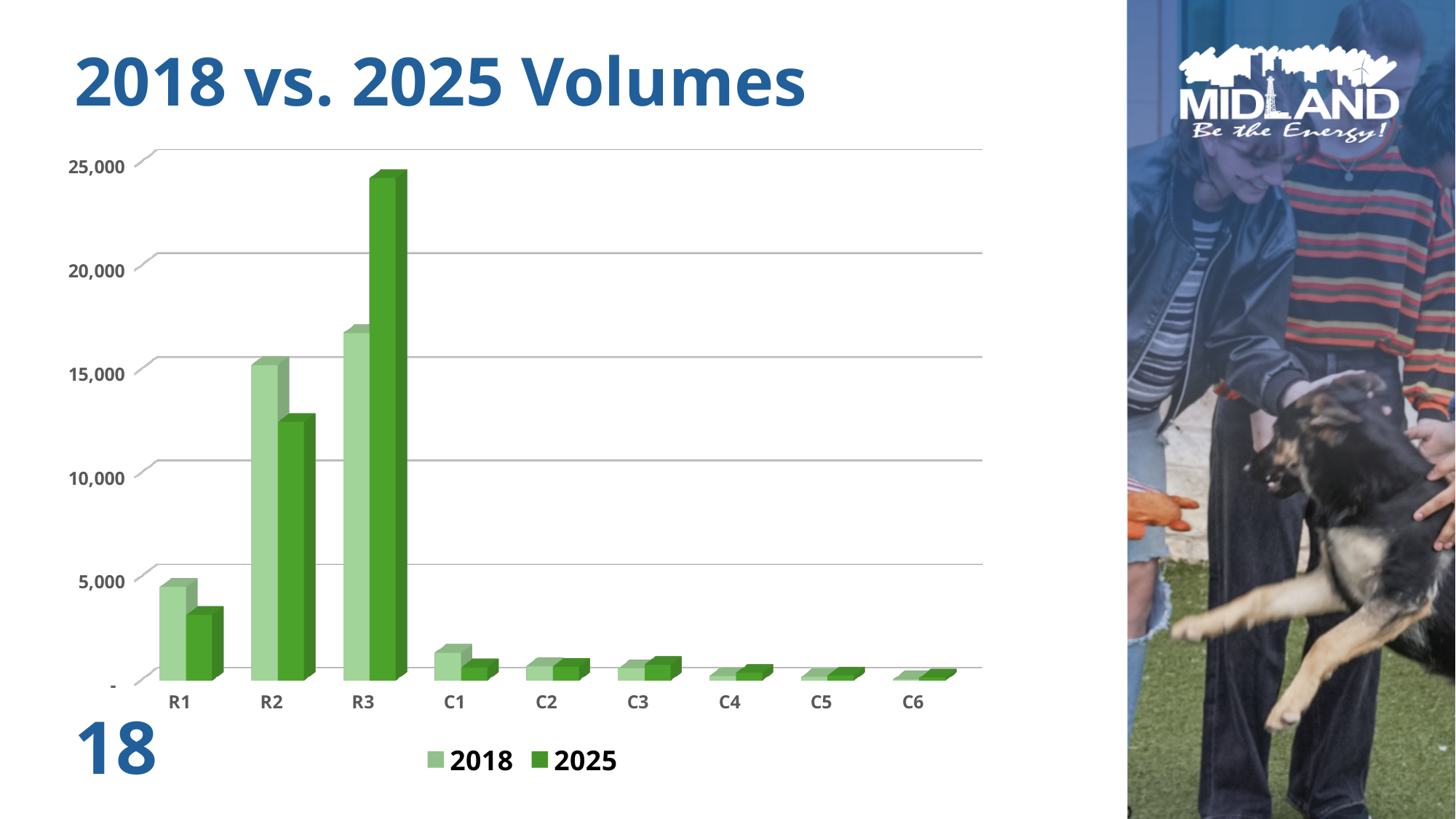
How many categories are shown on the x axis of the chart? 9 Which category has the highest 2025 value? R3 Is the 2025 value for R2 greater or less than 10,000? greater What kind of chart is shown on the slide? Bar chart For R2, which is larger: the 2018 value or the 2025 value? 2018 How many series does the chart's legend list? 2 For R1, which is larger: the 2018 value or the 2025 value? 2018 Which category has the highest 2018 value? R3 Is the 2018 value for R1 greater or less than 5,000? less For R3, which is larger: the 2018 value or the 2025 value? 2025 Is the 2025 value for R3 greater or less than 20,000? greater What is the title of the chart on the slide? 2018 vs. 2025 Volumes